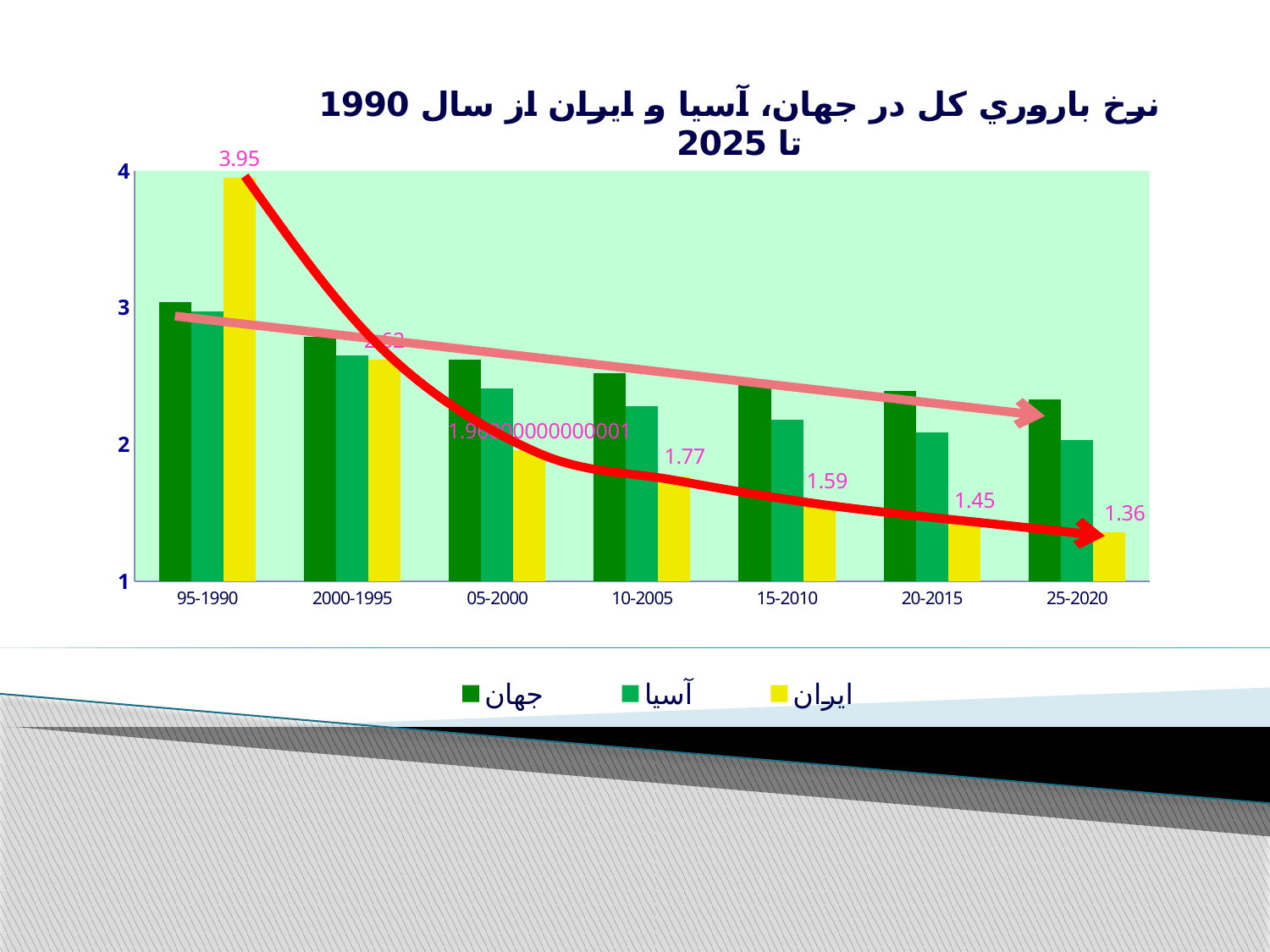
What is the difference between the ایران values for 95-1990 and 25-2020? 2.59 What is the value for ایران in the 25-2020 period? 1.36 What is the value for ایران in the 95-1990 period? 3.95 How many series does the legend list? 3 What is the value for ایران in the 20-2015 period? 1.45 Do the ایران values rise or fall from 95-1990 to 25-2020? fall What is the difference between the ایران values for 10-2005 and 15-2010? 0.18 Is the value for جهان in the 10-2005 period greater or less than 2? greater How many periods are shown on the x axis? 7 What is the value for ایران in the 10-2005 period? 1.77 In which period is the ایران value lowest? 25-2020 In which period is the ایران value highest? 95-1990